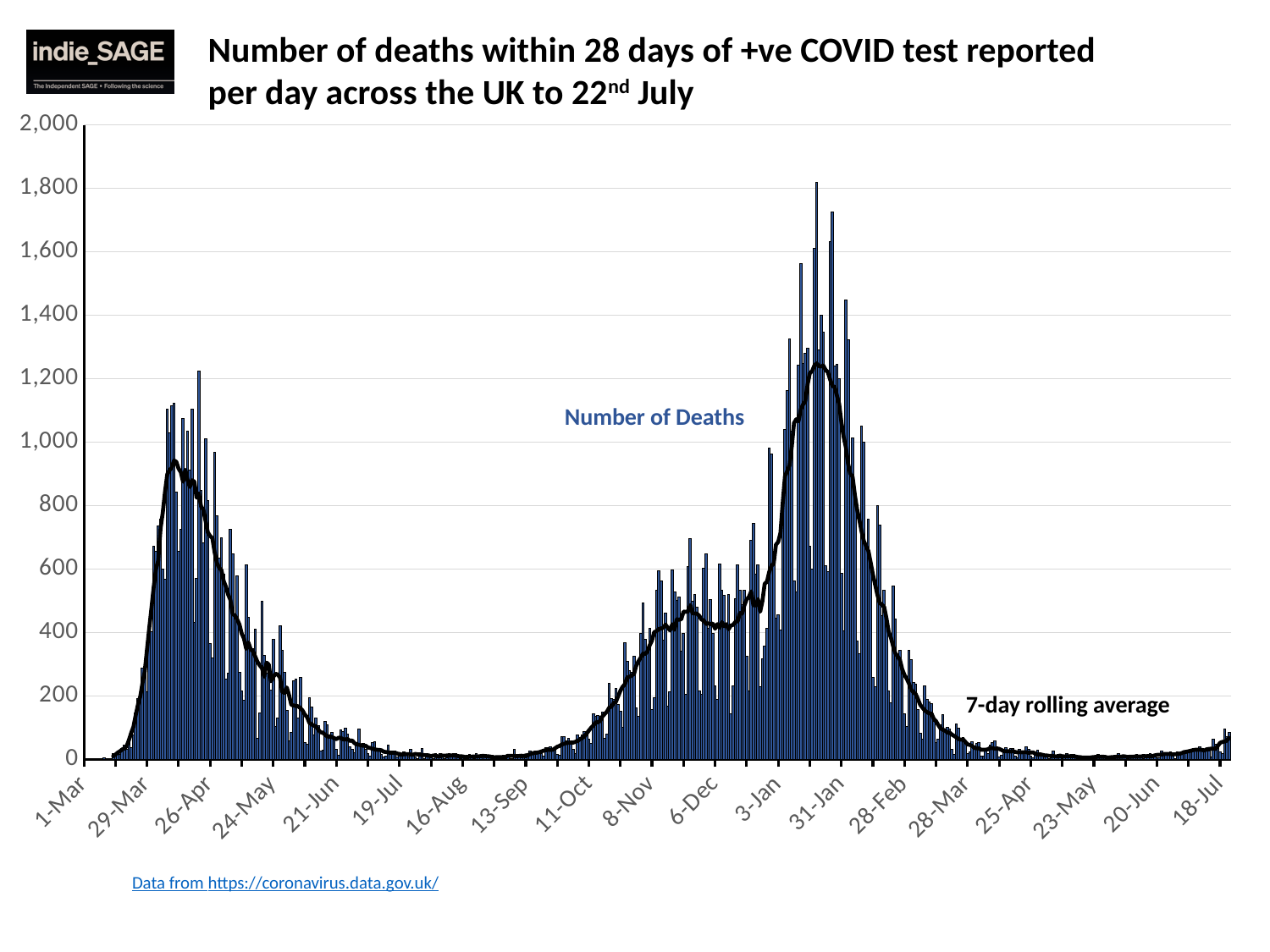
Does the 7-day rolling average rise or fall between 13-Sep and 8-Nov? Rise Are the daily death values around 16-Aug greater or less than 200? less Is the peak of the 7-day rolling average in January greater or less than 1,000? greater What kind of chart is used to show the Number of Deaths series? Bar chart How many data series are plotted on the chart? 2 Is the peak of the 7-day rolling average in April 2020 greater or less than 1,000? less What is the name of the series drawn as a black line? 7-day rolling average Does the 7-day rolling average rise or fall between 31-Jan and 28-Mar? Fall Which peak of the 7-day rolling average is higher: the one in April 2020 or the one in January 2021? January 2021 What is the highest value shown on the vertical axis? 2,000